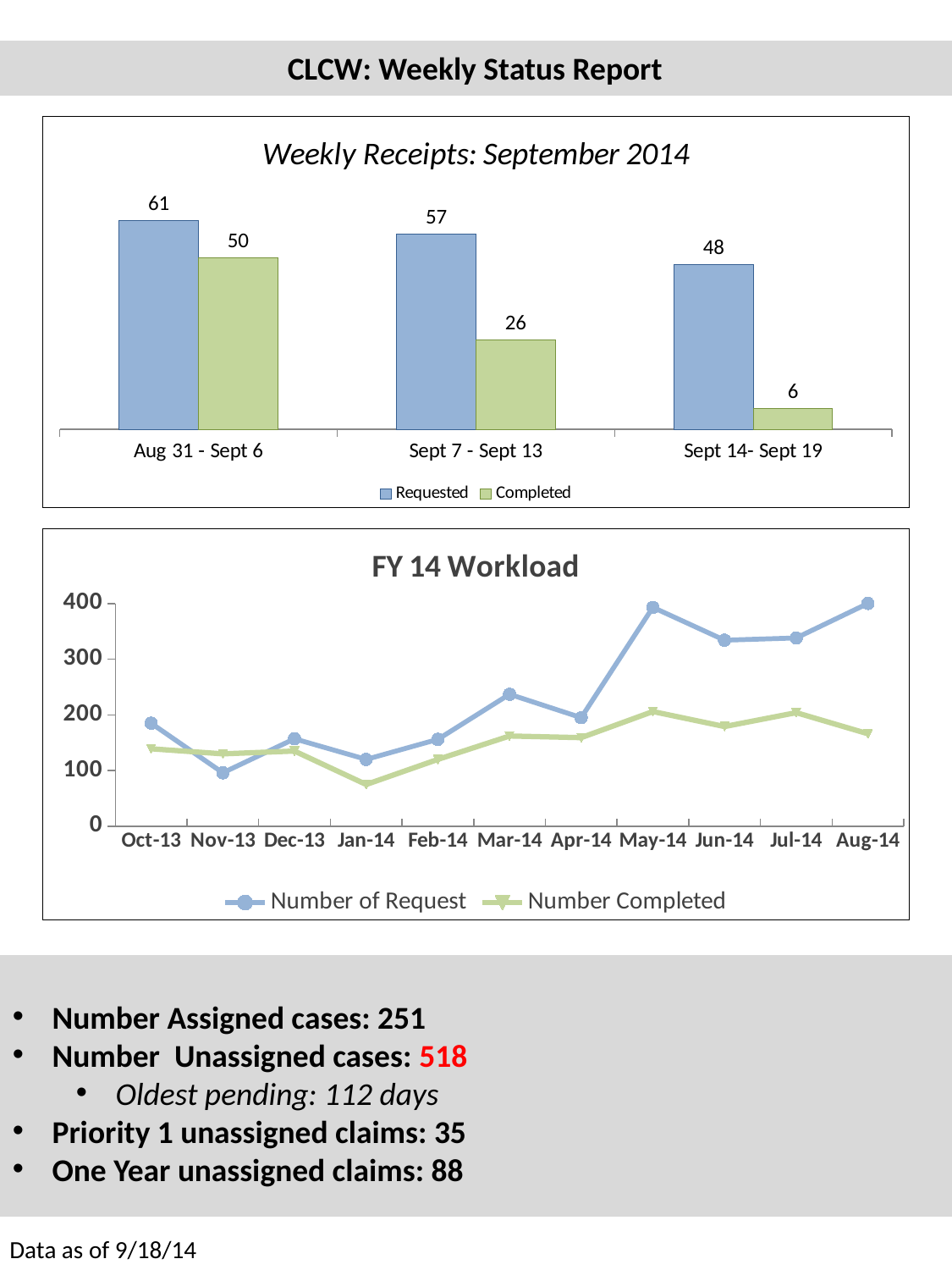
In the 'Weekly Receipts: September 2014' chart, how many weeks are shown on the x axis? 3 In the 'Weekly Receipts: September 2014' chart, what is the Completed value for Sept 14- Sept 19? 6 In the 'Weekly Receipts: September 2014' chart, do the Completed values rise or fall across the weeks? Fall In the 'Weekly Receipts: September 2014' chart, which week has the lowest Completed value? Sept 14- Sept 19 In the 'Weekly Receipts: September 2014' chart, what is the difference between Requested and Completed for Sept 7 - Sept 13? 31 In the 'FY 14 Workload' chart, which is larger in Aug-14: Number of Request or Number Completed? Number of Request In the 'Weekly Receipts: September 2014' chart, what kind of chart is it? Bar chart In the 'FY 14 Workload' chart, how many months are shown on the x axis? 11 In the 'FY 14 Workload' chart, is the Number Completed value for Jan-14 greater or less than 100? less In the 'FY 14 Workload' chart, how many series does the legend list? 2 In the 'Weekly Receipts: September 2014' chart, what is the Requested value for Aug 31 - Sept 6? 61 In the 'FY 14 Workload' chart, is the Number of Request value for May-14 greater or less than 300? greater